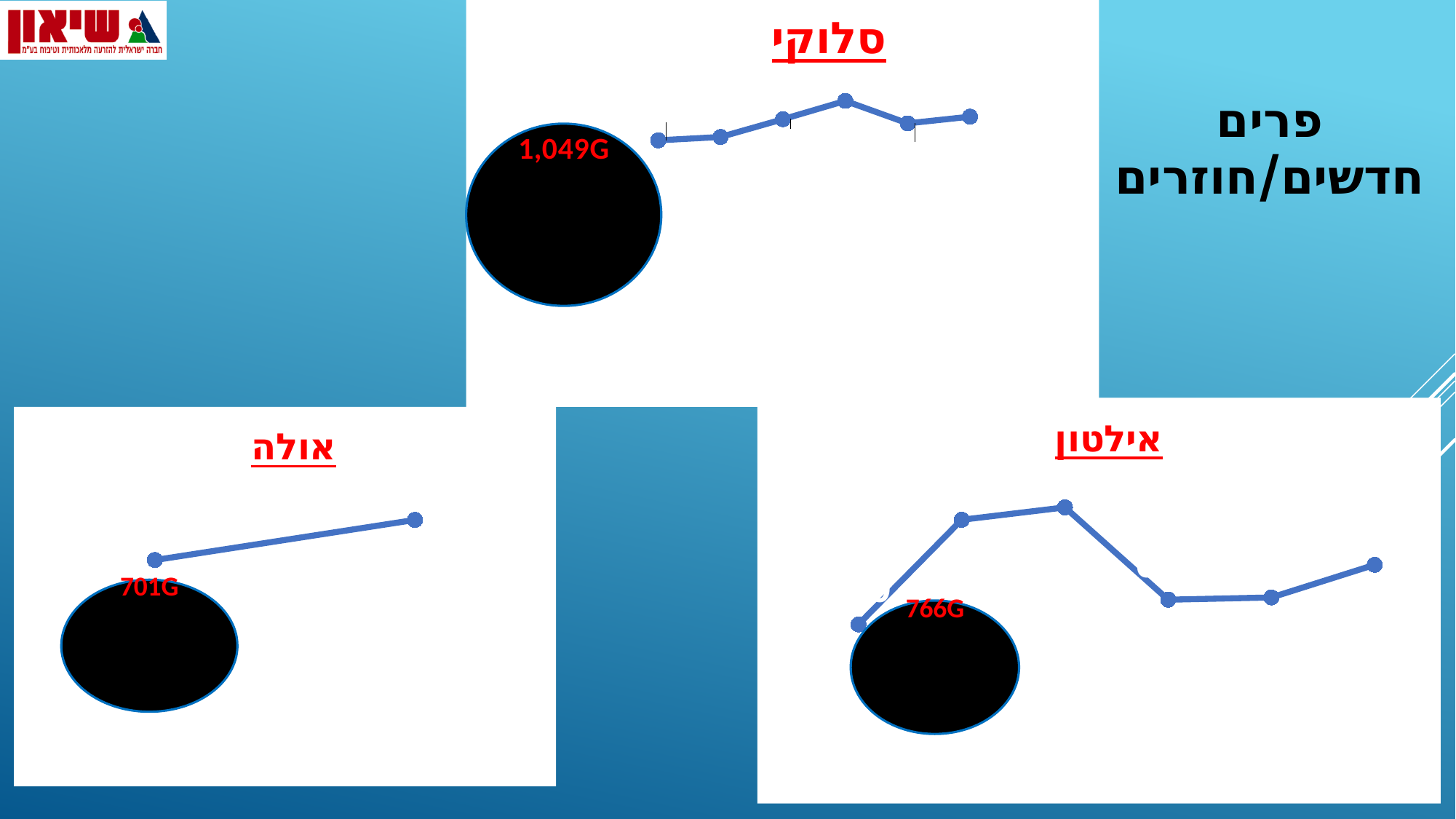
On the אילטון chart, is the second point from the left higher or lower than the fourth point? higher How many data points are plotted on the סלוקי chart? 6 What value is printed in the black circle on the אולה chart? 701G On the סלוקי chart, is the last point higher or lower than the first point? higher On the אילטון chart, which point is the highest? the third point from the left On the אולה chart, does the line rise or fall from left to right? rise What kind of chart is the סלוקי chart at the top of the slide? line chart How many data points are plotted on the אולה chart? 2 On the סלוקי chart, which point is the highest? the fourth point from the left What value is printed in the black circle on the סלוקי chart? 1,049G What kind of chart is the אולה chart at the bottom left? line chart